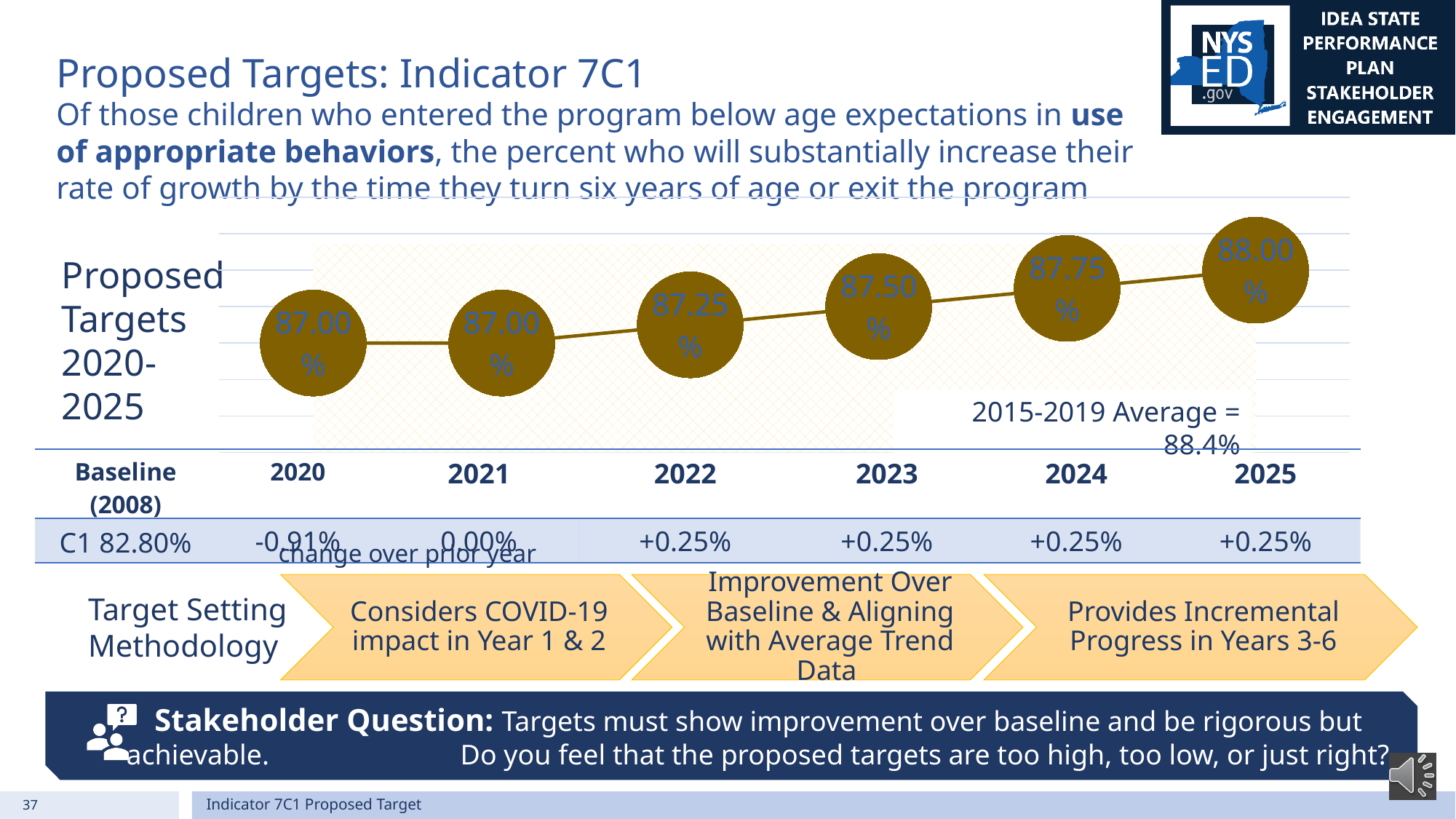
What is the baseline (2008) value shown below the chart? 82.80% How many years are plotted on the chart? 6 What is the proposed target for 2025? 88.00% What is the proposed target for 2022? 87.25% What kind of chart is shown on the slide? Line chart Is the proposed target for 2024 larger than the proposed target for 2022? Yes What is the difference between the proposed targets for 2024 and 2023? 0.25% What is the difference between the proposed targets for 2025 and 2020? 1.00% What is the 2015-2019 average shown on the chart? 88.4% Do the proposed targets rise or fall from 2021 to 2025? Rise Which year has the highest proposed target? 2025 What is the proposed target for 2020? 87.00%